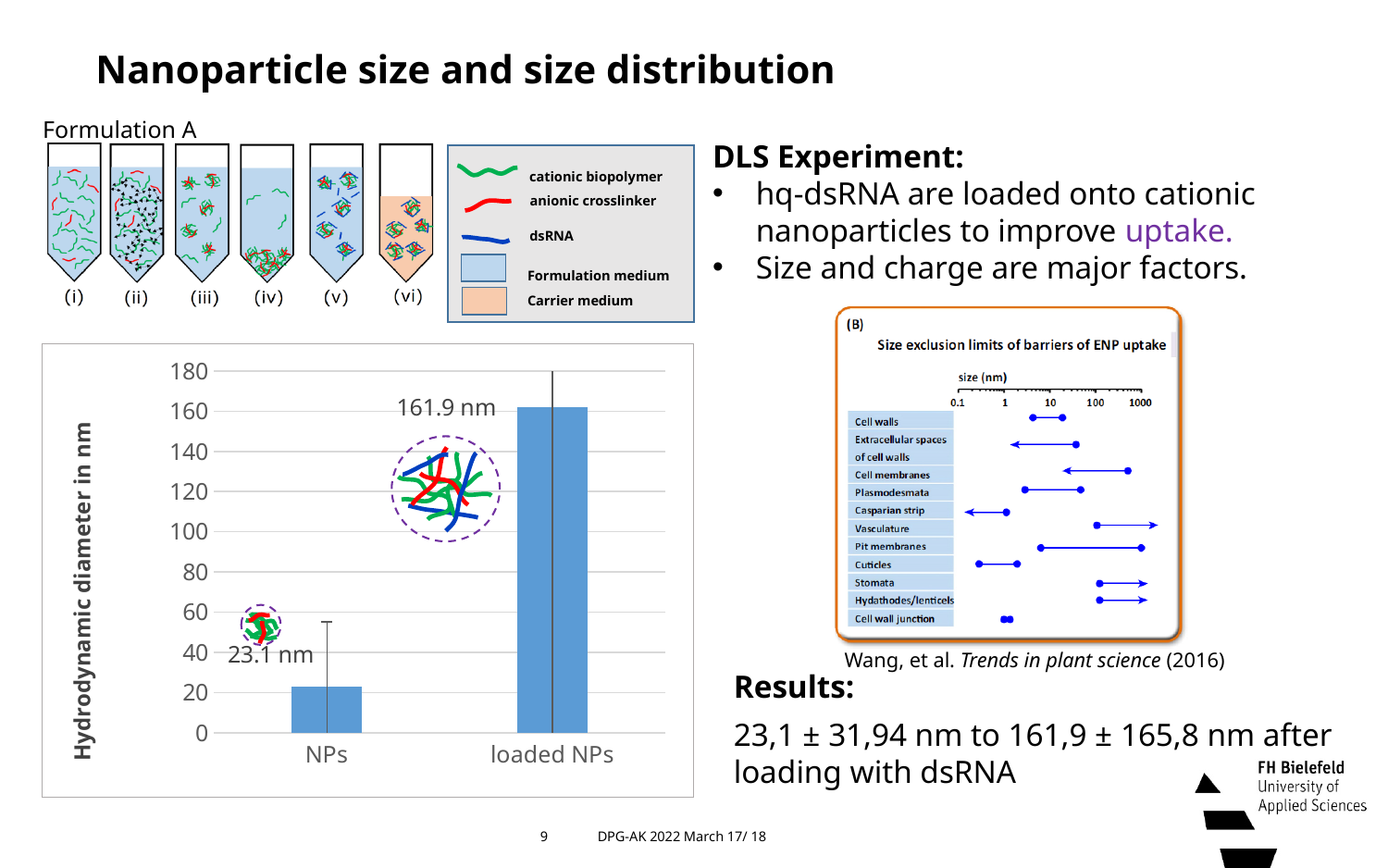
Which category in the bar chart has the largest hydrodynamic diameter? loaded NPs What is the label of the vertical axis of the bar chart? Hydrodynamic diameter in nm In the bar chart, is the value for loaded NPs greater or less than 140? greater What is the hydrodynamic diameter shown for NPs in the bar chart? 23.1 nm What kind of chart is used to show the hydrodynamic diameter? bar chart What is the hydrodynamic diameter shown for loaded NPs in the bar chart? 161.9 nm In the bar chart, which is larger: the value for NPs or the value for loaded NPs? loaded NPs In the bar chart, is the value for NPs greater or less than 40? less How many categories are plotted in the bar chart? 2 Do the values in the bar chart rise or fall from NPs to loaded NPs? rise Which category in the bar chart has the smallest hydrodynamic diameter? NPs What is the difference in hydrodynamic diameter between loaded NPs and NPs in the bar chart? 138.8 nm